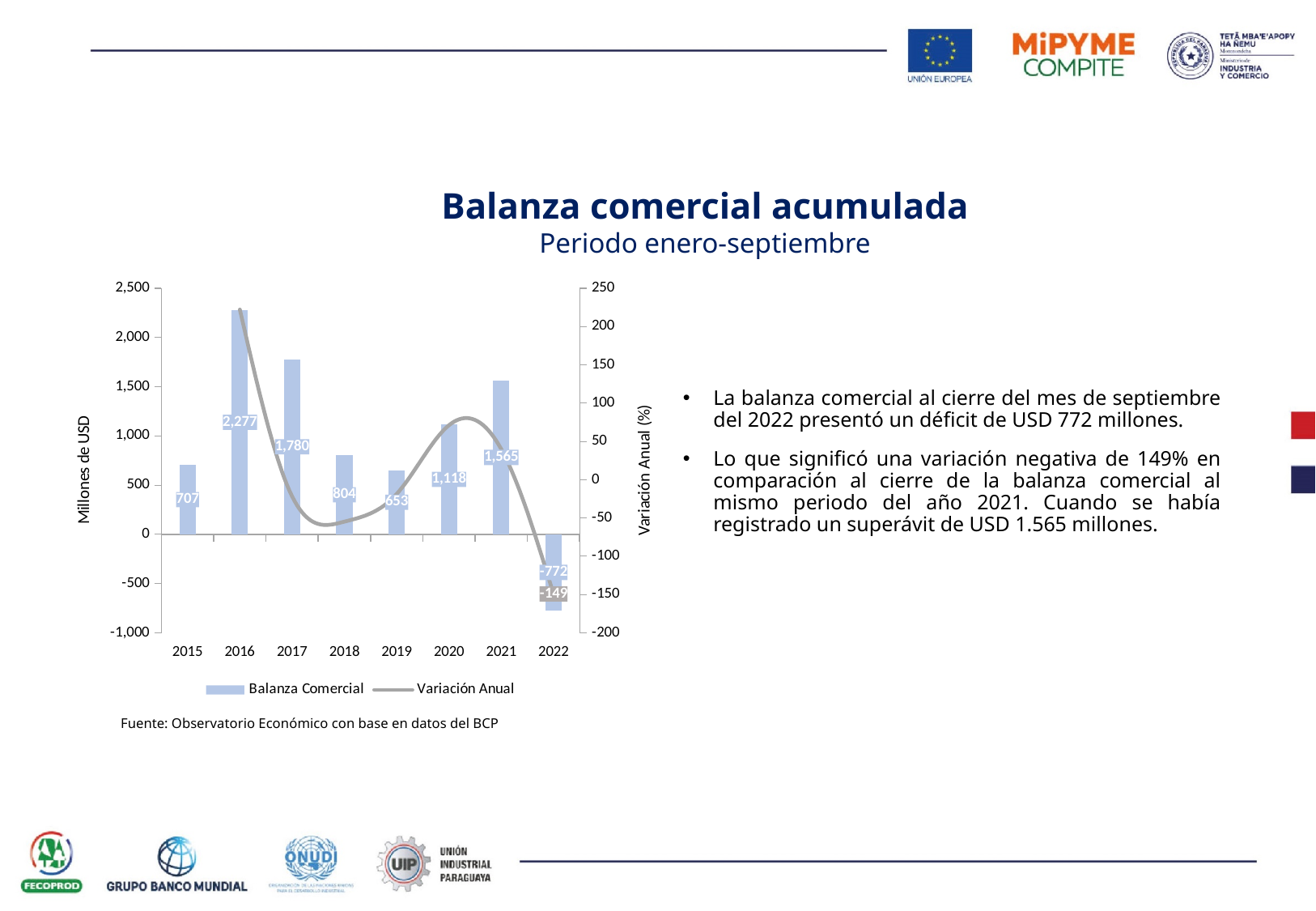
Which year has a larger Balanza Comercial value, 2018 or 2020? 2020 Which year has the lowest Balanza Comercial value? 2022 What is the Balanza Comercial value for 2019? 653 How many years are shown on the x axis? 8 Is the Variación Anual value for 2016 greater or less than 200? greater What is the Variación Anual value shown for 2022? -149 What kind of chart is this? Combined bar and line chart What is the Balanza Comercial value for 2016? 2,277 Which year has the highest Balanza Comercial value? 2016 Do the Balanza Comercial values rise or fall from 2016 to 2019? Fall How many series does the legend list? 2 What is the difference between the Balanza Comercial values for 2016 and 2017? 497